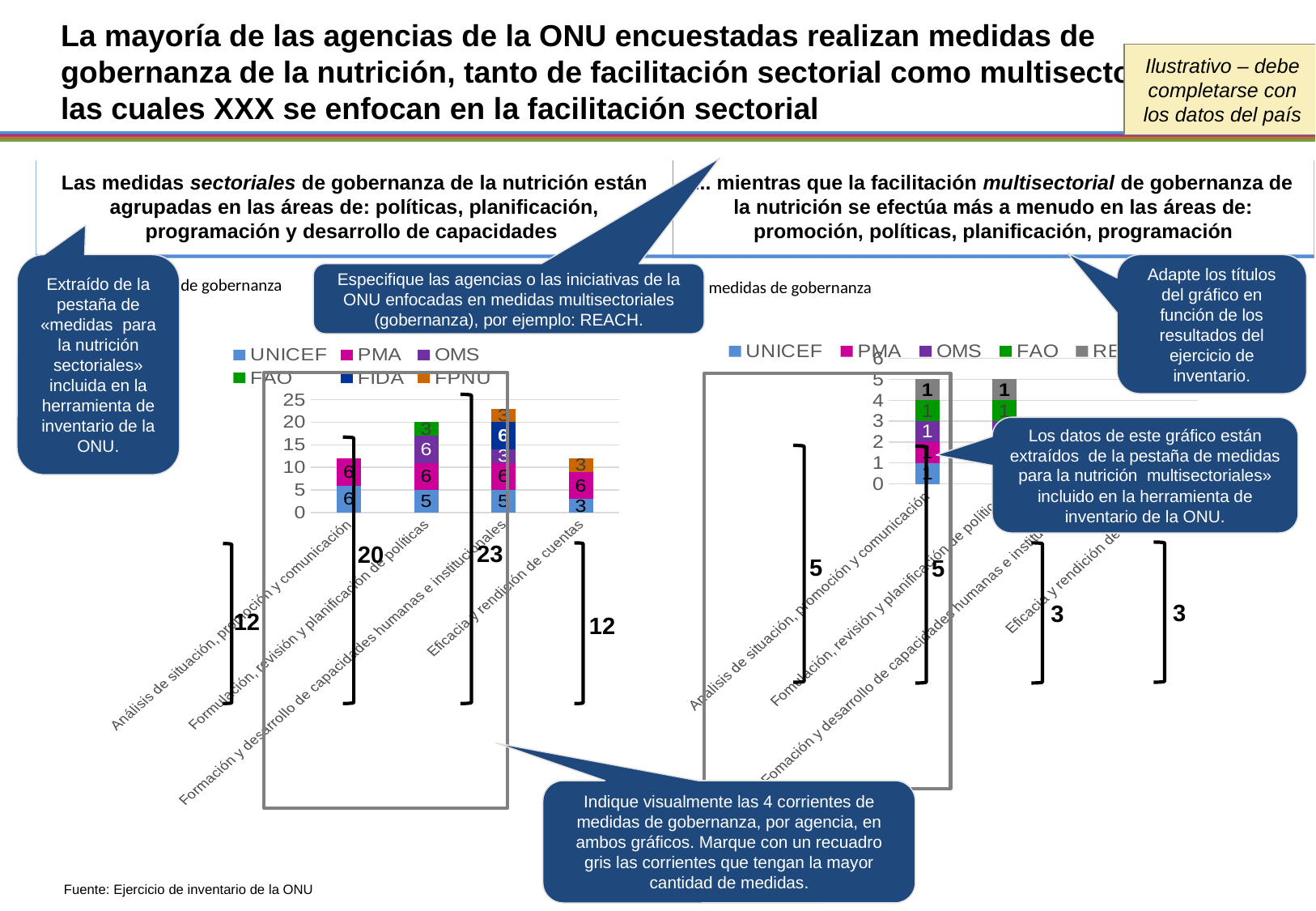
In the left chart, what is the total of the stacked bar for 'Formación y desarrollo de capacidades humanas e institucionales'? 23 How many series does the legend of the left chart list? 6 In the left chart, what is the total of the stacked bar for 'Formulación, revisión y planificación de políticas'? 20 What kind of chart is the left chart on the slide? Stacked bar chart In the left chart, which category has the highest stacked total? Formación y desarrollo de capacidades humanas e institucionales In the left chart, is the UNICEF value larger for 'Análisis de situación, promoción y comunicación' or for 'Eficacia y rendición de cuentas'? Análisis de situación, promoción y comunicación In the right chart, what is the UNICEF value for 'Análisis de situación, promoción y comunicación'? 1 In the left chart, what is the difference between the PMA value and the UNICEF value for 'Eficacia y rendición de cuentas'? 3 In the left chart, what is the OMS value for 'Formulación, revisión y planificación de políticas'? 6 How many categories are shown on the x axis of the left chart? 4 In the left chart, what is the FIDA value for 'Formación y desarrollo de capacidades humanas e institucionales'? 6 In the left chart, what is the UNICEF value for 'Análisis de situación, promoción y comunicación'? 6